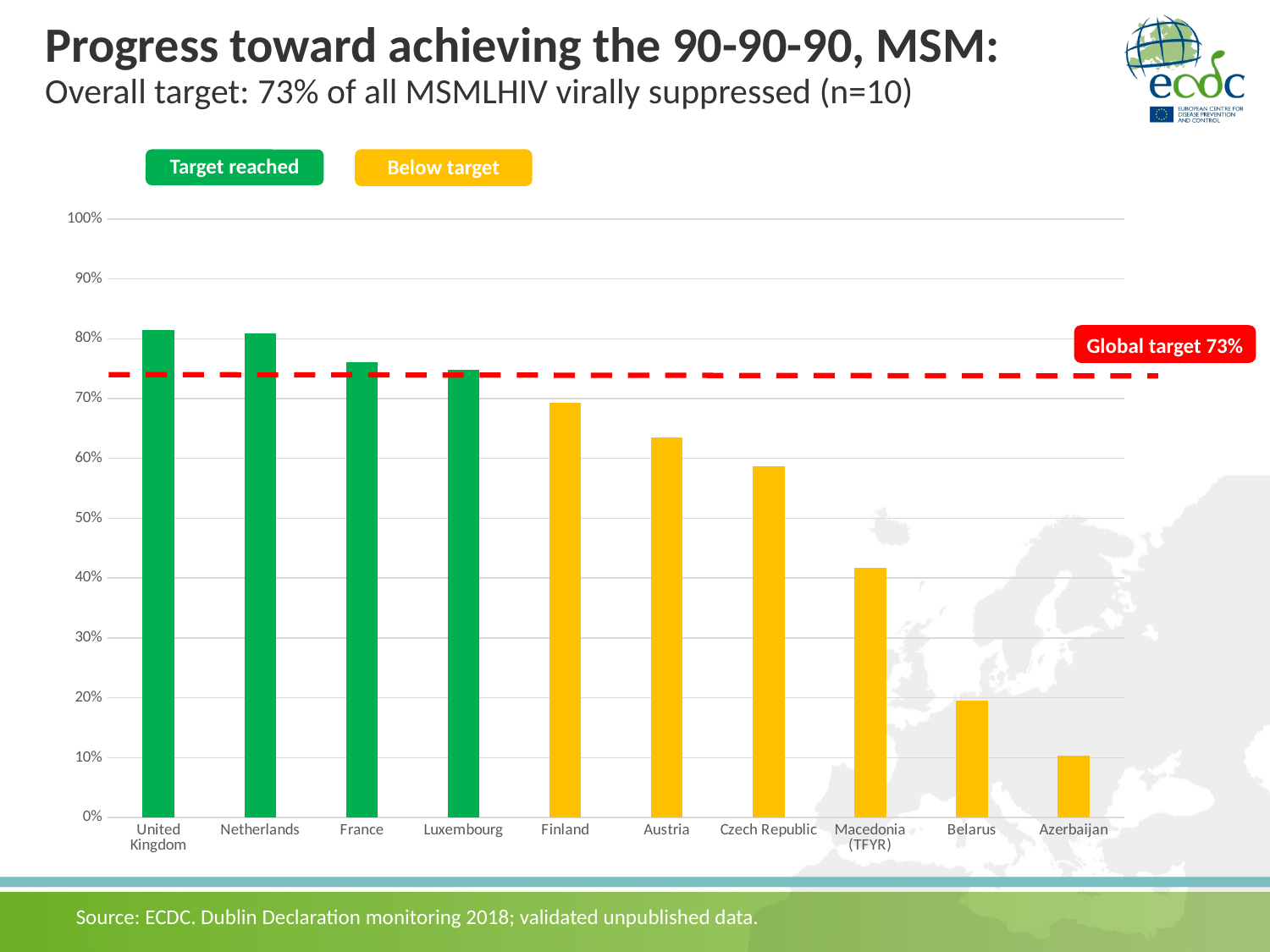
Is the value for Macedonia (TFYR) greater or less than 40%? greater Is the value for Finland greater or less than 70%? less How many countries are shown on the x axis of the chart? 10 Is the value for Czech Republic greater or less than 60%? less What kind of chart is shown on the slide? bar chart How many countries are shown with green bars, indicating the target was reached? 4 What global target percentage is marked by the dashed red line? 73% Do the values rise or fall moving from left to right along the x axis? fall Which country has the lowest value in the chart? Azerbaijan Which is larger, the value for France or the value for Finland? France